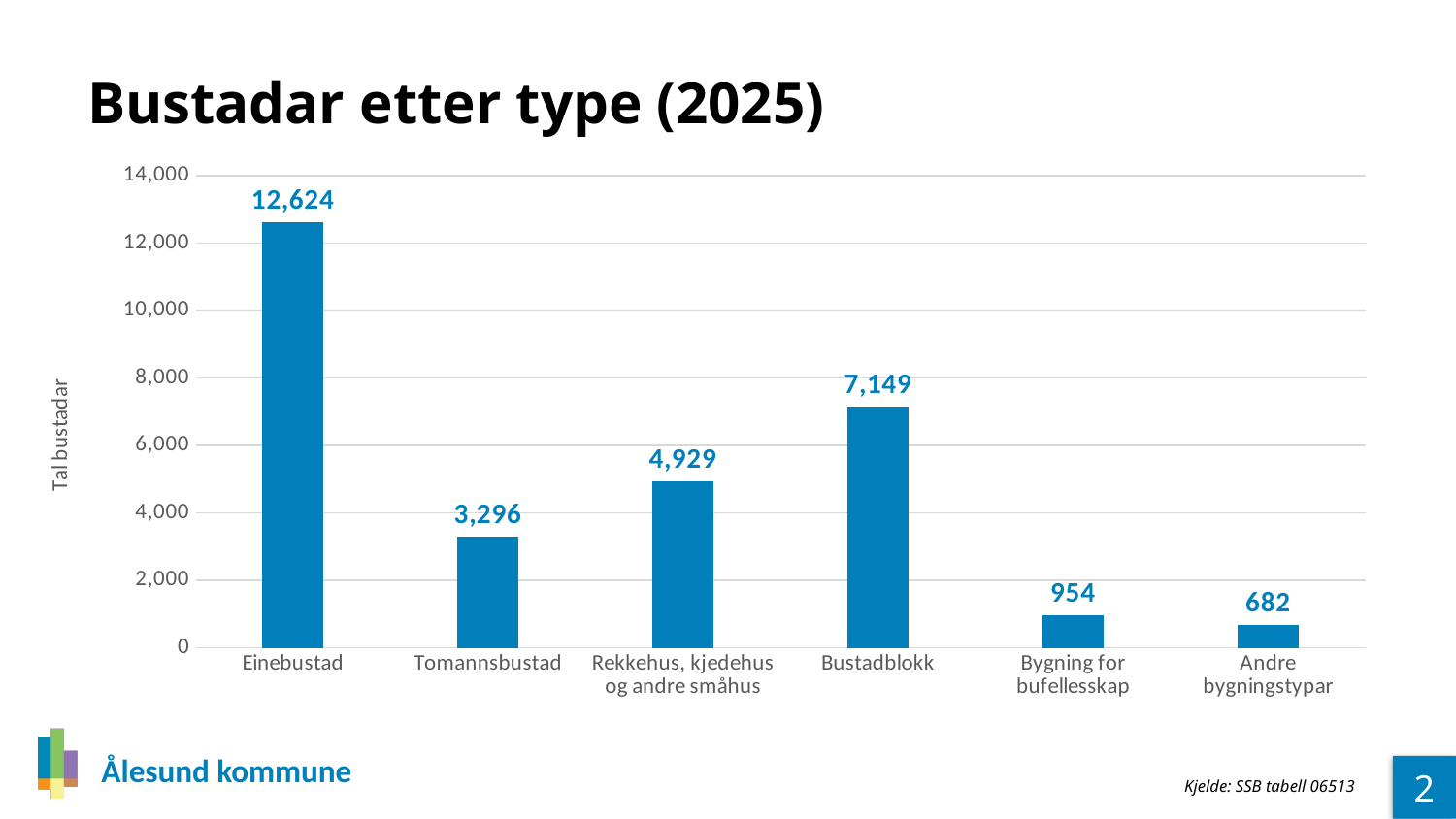
What is the title of the chart? Bustadar etter type (2025) What is the value for Einebustad? 12,624 What is the value for Bygning for bufellesskap? 954 What is the difference between the values for Einebustad and Bustadblokk? 5,475 Which category has the highest value? Einebustad How many categories are shown on the x axis? 6 What is the difference between the values for Rekkehus, kjedehus og andre småhus and Tomannsbustad? 1,633 Which category has the lowest value? Andre bygningstypar Which is larger, the value for Tomannsbustad or the value for Rekkehus, kjedehus og andre småhus? Rekkehus, kjedehus og andre småhus Is the value for Bustadblokk greater or less than 8,000? less What is the value for Bustadblokk? 7,149 What kind of chart is shown on the slide? bar chart